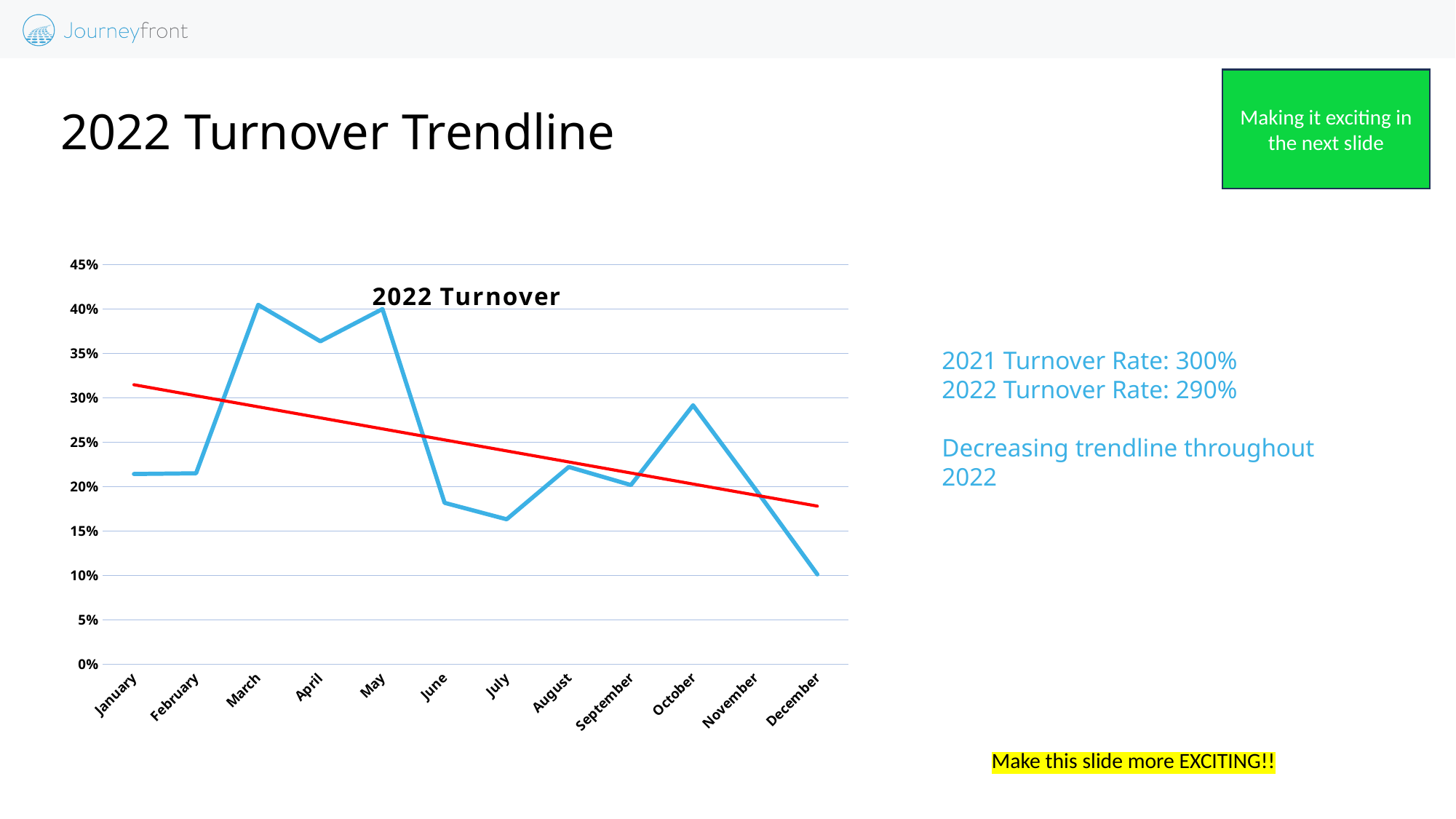
Which month has the higher turnover value, October or November? October Is the turnover value for June greater or less than 20%? less How many months are plotted on the x axis of the 2022 Turnover chart? 12 What kind of chart is shown on the slide? line chart Which month has the higher turnover value, April or June? April Which month has the lowest turnover value in the 2022 Turnover chart? December Is the turnover value for October greater or less than 25%? greater What is the title printed inside the chart area? 2022 Turnover Is the turnover value for March greater or less than 35%? greater Does the red trendline rise or fall from January to December? fall